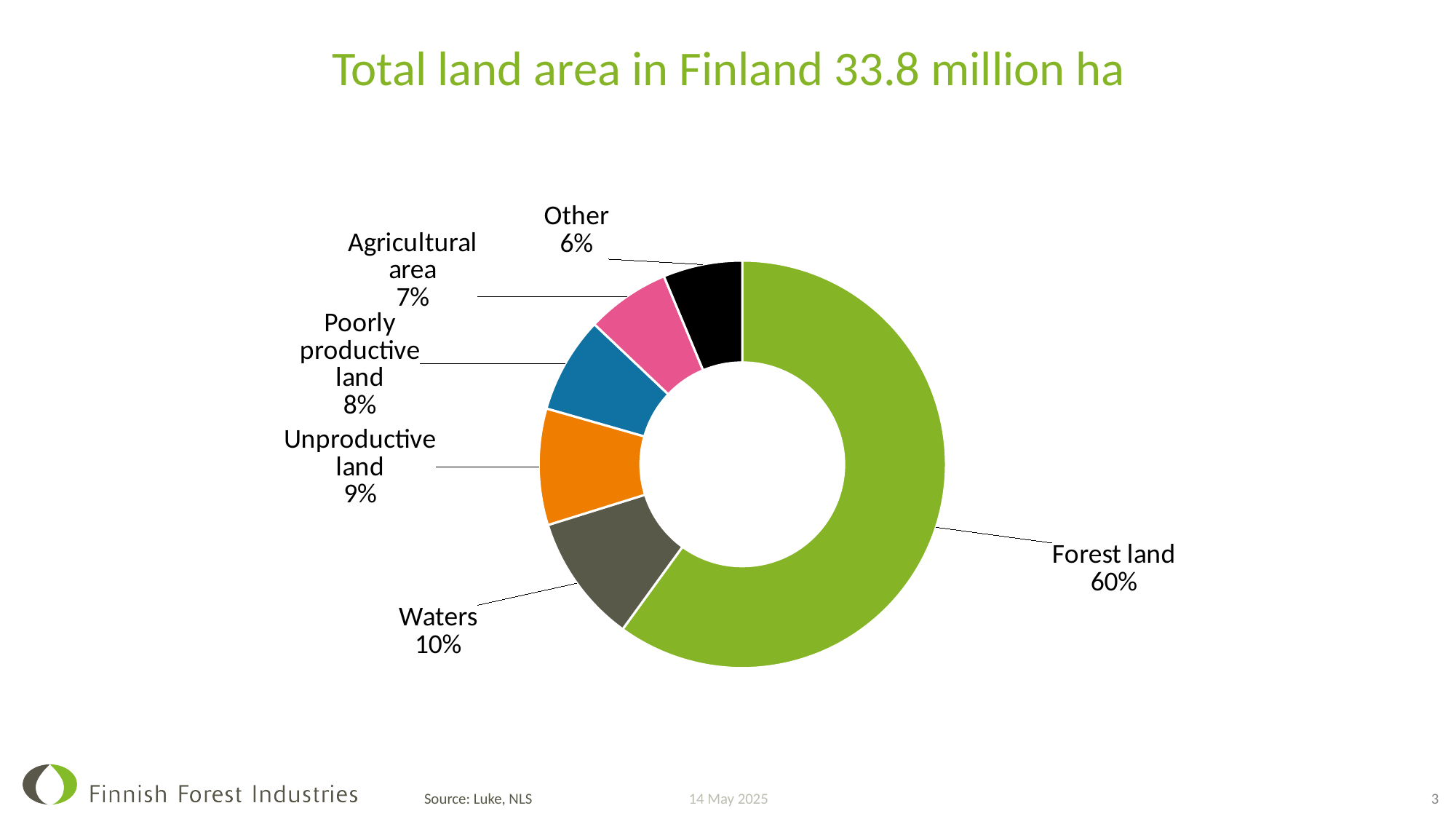
What share of Finland's total land area is Forest land? 60% Which has a larger share, Unproductive land or Agricultural area? Unproductive land What share of the total land area is Waters? 10% What kind of chart is shown on the slide? Pie chart (doughnut) What is the title of the slide? Total land area in Finland 33.8 million ha How many categories are shown in the chart? 6 What share of the total land area is Poorly productive land? 8% What share of the total land area is Unproductive land? 9% What share of the total land area is Agricultural area? 7% Which category has the smallest share of the total land area? Other How many percentage points larger is the Forest land share than the Waters share? 50 Which category has the largest share of the total land area? Forest land